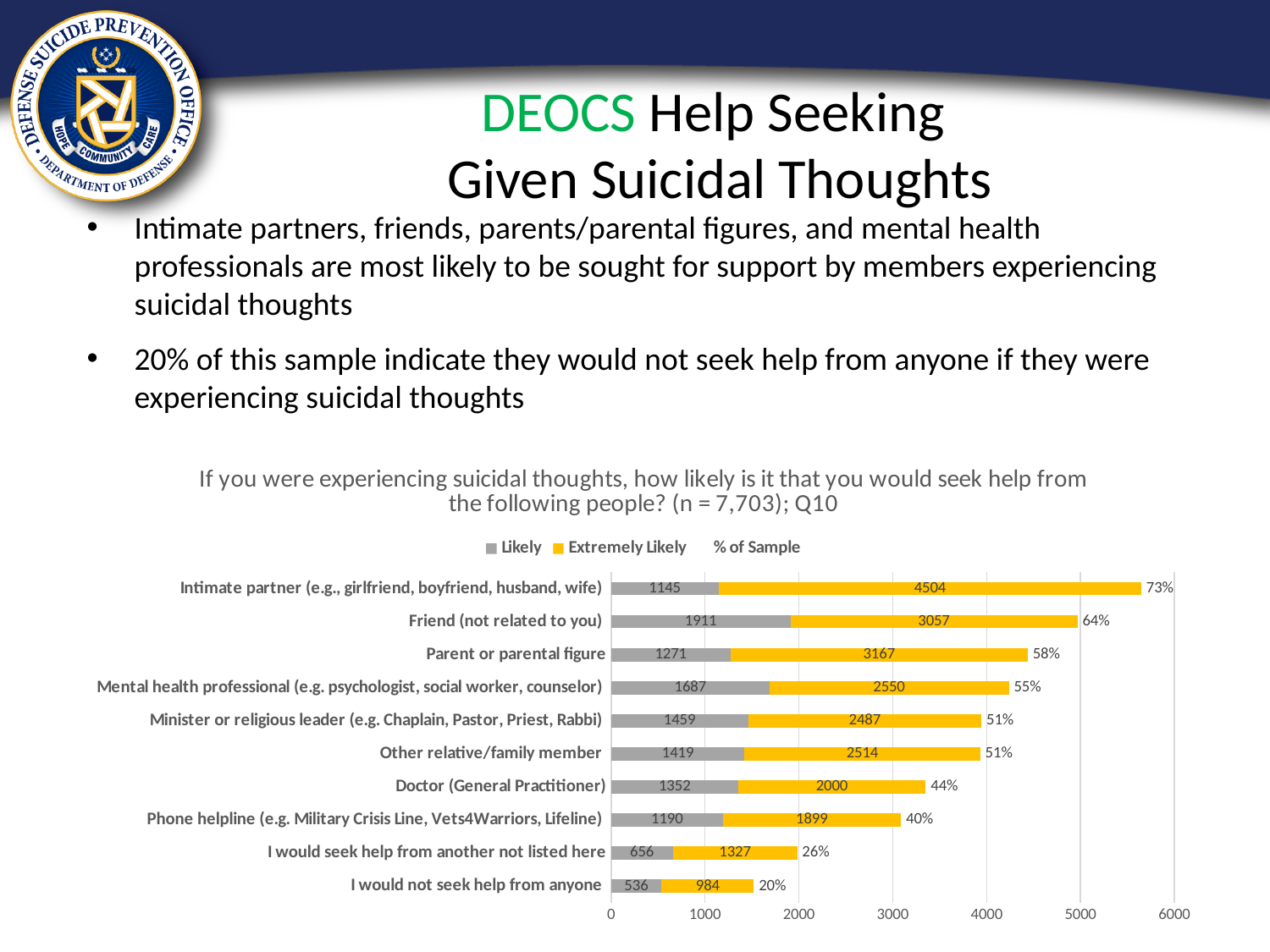
How many categories (sources of help) are listed on the chart? 10 How many entries does the chart legend list? 3 Which category has the highest '% of Sample' value? Intimate partner (e.g., girlfriend, boyfriend, husband, wife) What is the 'Extremely Likely' value for 'Intimate partner (e.g., girlfriend, boyfriend, husband, wife)'? 4504 What is the difference between the 'Extremely Likely' values for 'Parent or parental figure' and 'Doctor (General Practitioner)'? 1167 What type of chart is shown on the slide? Stacked bar chart What is the total of the stacked bar for 'I would not seek help from anyone'? 1520 Which has a larger 'Likely' value: 'Mental health professional' or 'Minister or religious leader'? Mental health professional What is the 'Likely' value for 'Friend (not related to you)'? 1911 What percentage of the sample is shown for 'Mental health professional (e.g. psychologist, social worker, counselor)'? 55% What is the title of the chart? If you were experiencing suicidal thoughts, how likely is it that you would seek help from the following people? (n = 7,703); Q10 Which category has the lowest 'Extremely Likely' value? I would not seek help from anyone